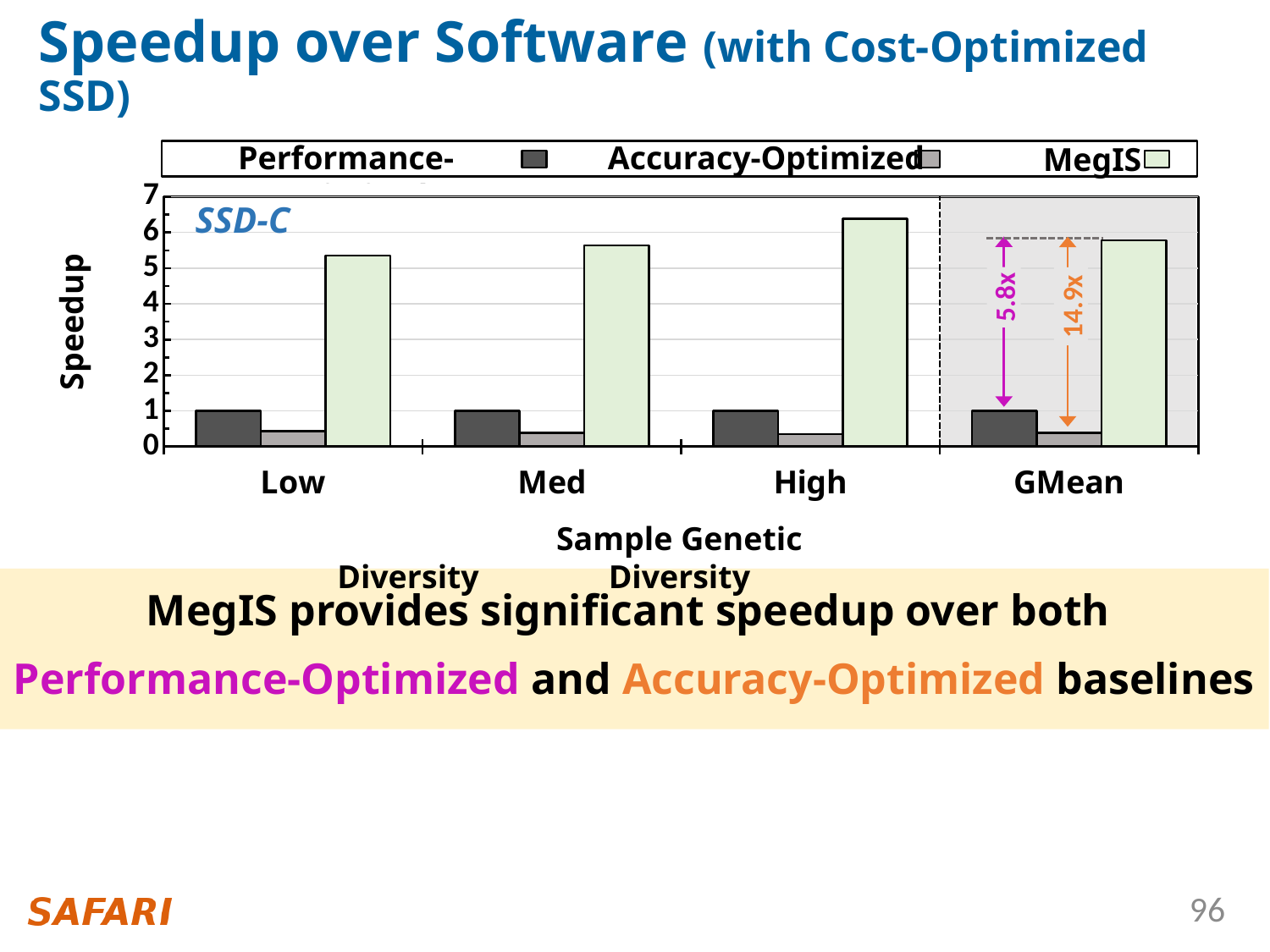
How many series does the legend list? 3 What speedup of MegIS over the Performance-Optimized baseline is annotated at GMean? 5.8x Which series has the lowest bar in the Low category? Accuracy-Optimized Is the MegIS value for High greater or less than 6? greater What kind of chart is shown on the slide? bar chart What speedup of MegIS over the Accuracy-Optimized baseline is annotated at GMean? 14.9x Is the MegIS value for Low greater or less than 6? less Which is larger, the MegIS bar for High or the MegIS bar for Low? High Is the Accuracy-Optimized value for Med greater or less than 1? less Which category has the highest MegIS bar? High How many categories are shown on the x axis? 4 What is the label on the y axis of the chart? Speedup